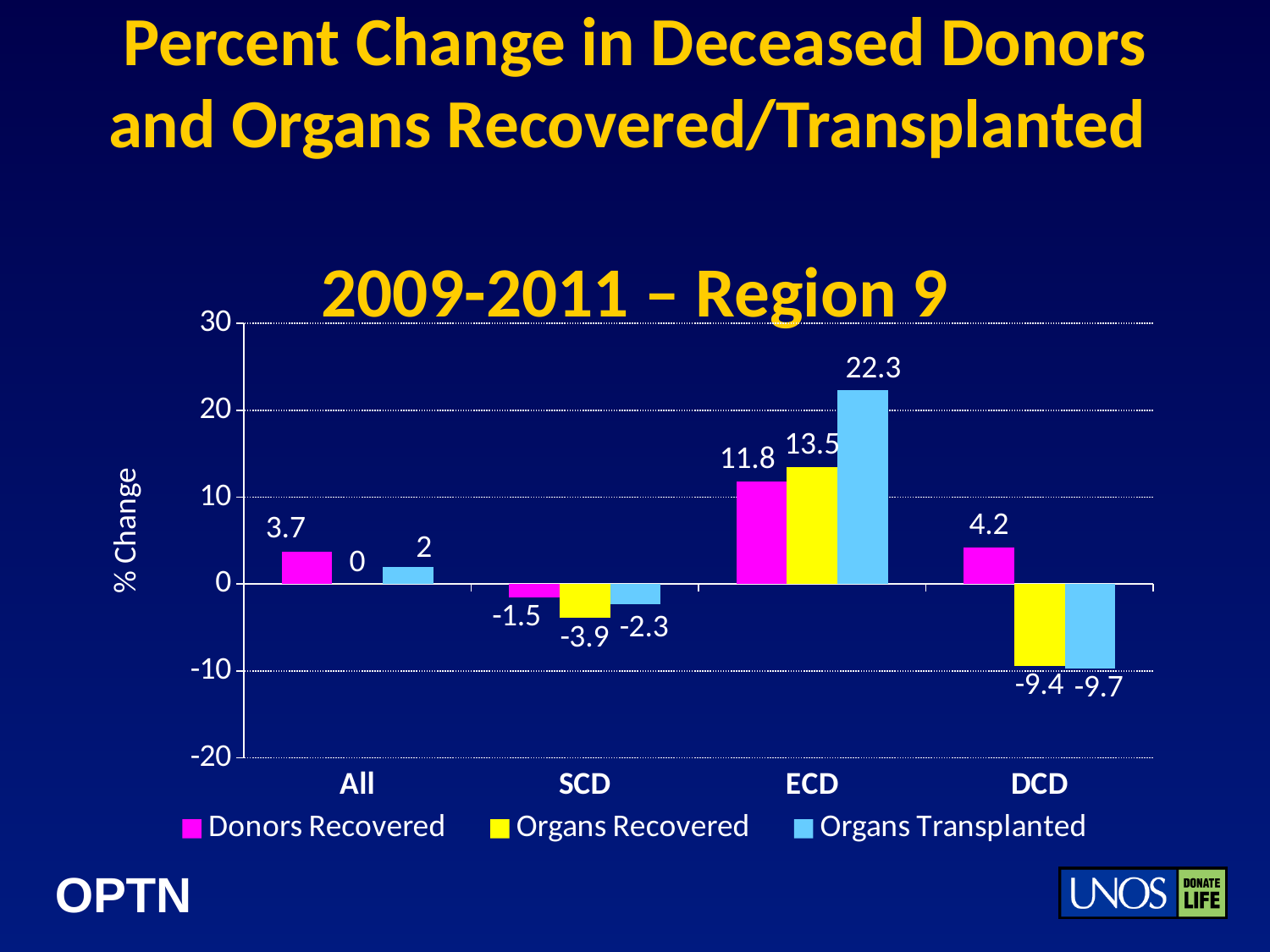
Which category has the lowest Organs Recovered percent change? DCD What kind of chart is shown on the slide? Bar chart What is the difference between the Organs Transplanted and Donors Recovered percent changes for ECD? 10.5 What is the chart's title? 2009-2011 – Region 9 How many categories are shown on the x axis? 4 What is the percent change in Organs Recovered for SCD? -3.9 For DCD, which is larger: the Donors Recovered percent change or the Organs Recovered percent change? Donors Recovered Which category has the highest Organs Transplanted percent change? ECD What is the percent change in Organs Transplanted for ECD? 22.3 What is the percent change in Donors Recovered for DCD? 4.2 What is the percent change in Organs Recovered for All? 0 How many series does the legend list? 3